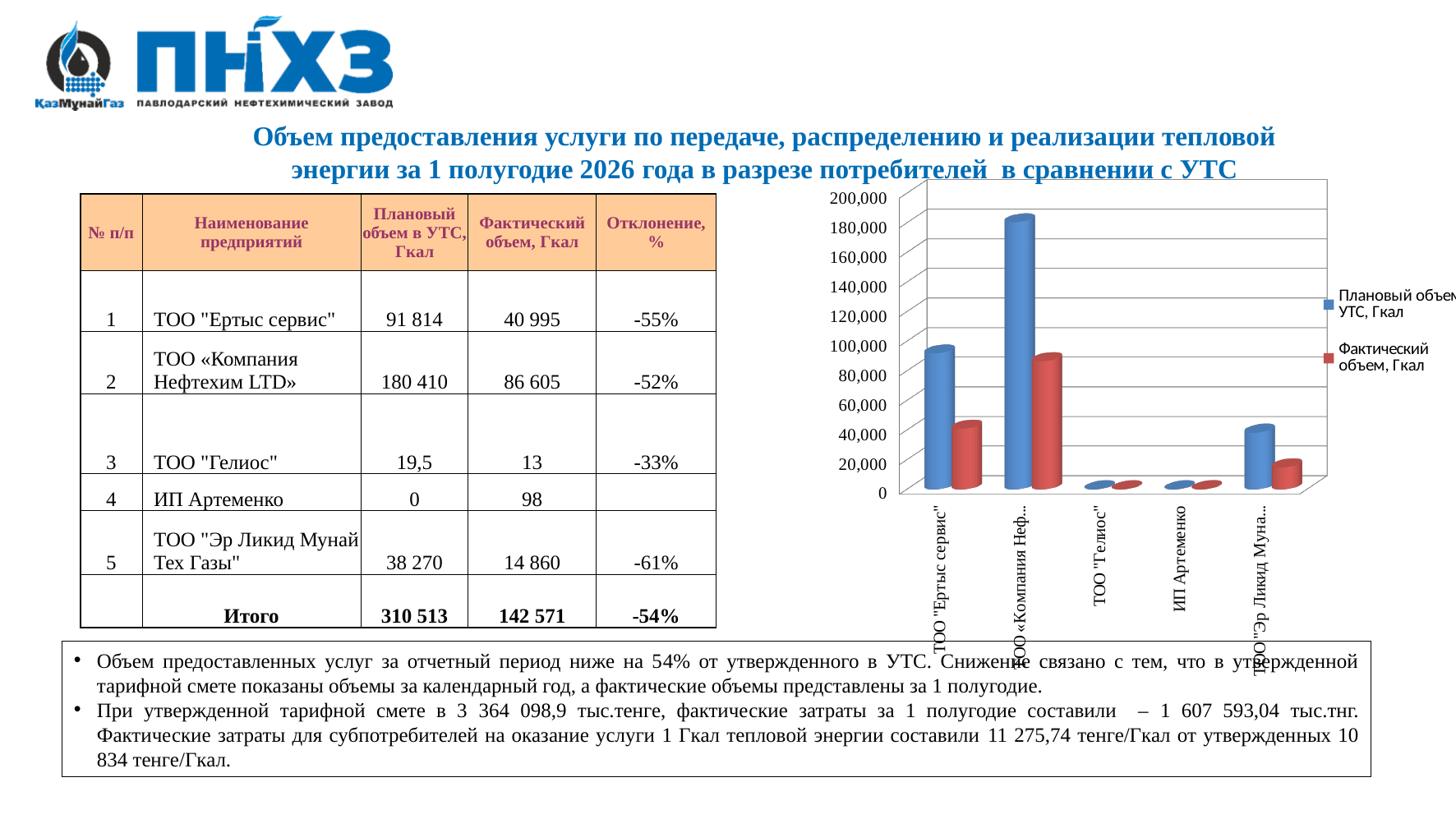
How many series does the chart legend list? 2 Which category has the lowest planned volume (Плановый объем УТС, Гкал) on the chart? ИП Артеменко Which colour represents the series "Фактический объем, Гкал" in the chart? red What is the difference between the planned and actual volume for ТОО "Ертыс сервис" (Гкал)? 50 819 Is the actual volume (Фактический объем) for ТОО "Эр Ликид Мунай Тех Газы" greater or less than 20,000? less For ТОО "Ертыс сервис", which is larger: the planned volume or the actual volume? planned volume What kind of chart is shown on the slide? bar chart What is the planned volume in УТС (Гкал) for ТОО "Ертыс сервис"? 91 814 Which category has the highest planned volume (Плановый объем УТС, Гкал) on the chart? ТОО «Компания Нефтехим LTD» Which category has the highest actual volume (Фактический объем, Гкал) on the chart? ТОО «Компания Нефтехим LTD» Is the planned volume (Плановый объем УТС) for ТОО «Компания Нефтехим LTD» greater or less than 160,000? greater How many consumer categories are plotted on the chart's x axis? 5